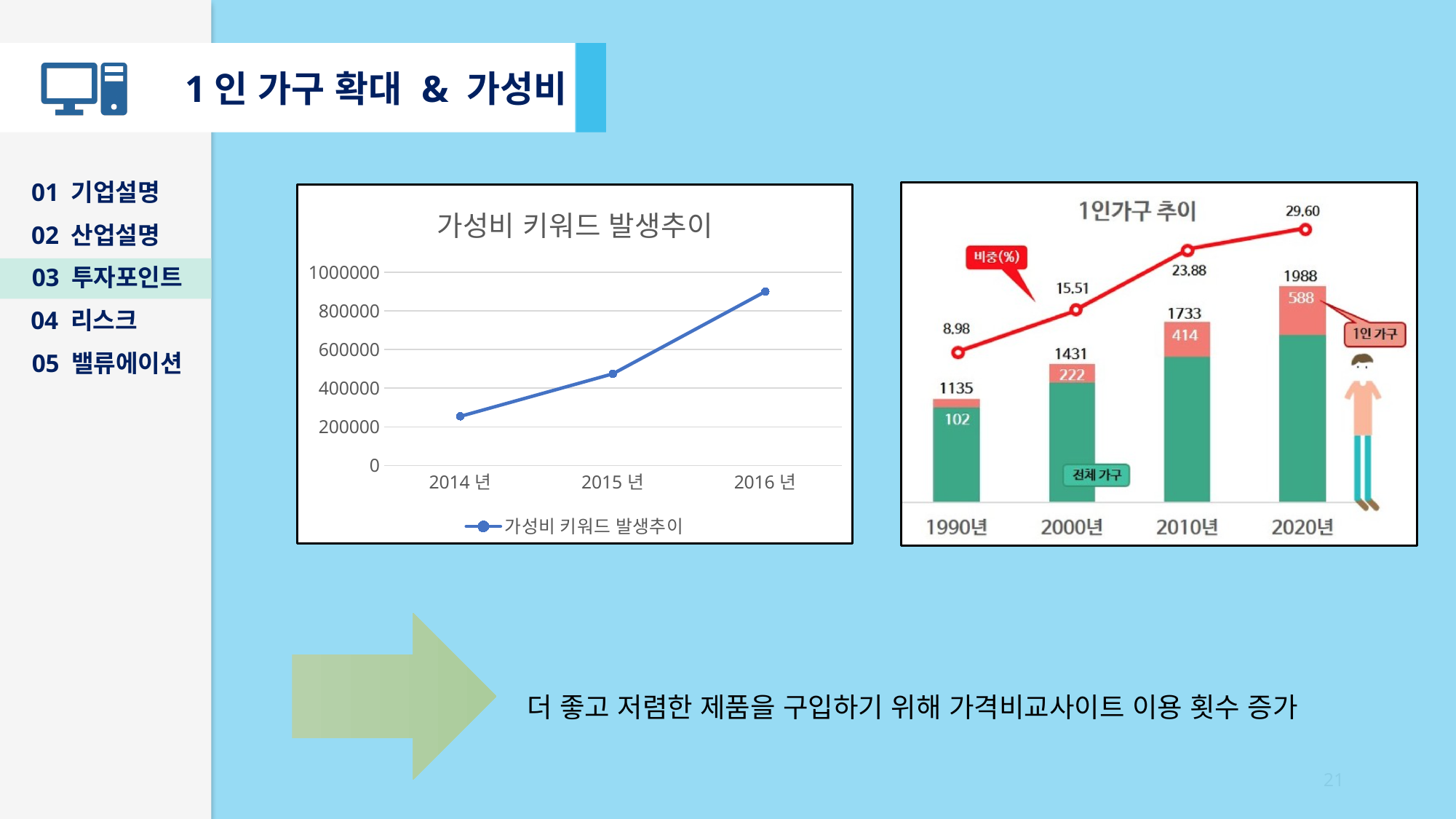
In the chart titled 1인가구 추이 on the right, what is the 1인 가구 value for 2020년? 588 In the chart titled 가성비 키워드 발생추이 on the left, do the values rise or fall from 2014 년 to 2016 년? rise In the chart titled 가성비 키워드 발생추이 on the left, is the value for 2014 년 greater or less than 400000? less In the chart titled 가성비 키워드 발생추이 on the left, what kind of chart is it? line chart In the chart titled 가성비 키워드 발생추이 on the left, is the value for 2016 년 greater or less than 800000? greater In the chart titled 1인가구 추이 on the right, which year has the lowest 1인 가구 value? 1990년 In the chart titled 1인가구 추이 on the right, what is the difference between the 1인 가구 values for 2010년 and 2000년? 192 In the chart titled 1인가구 추이 on the right, which year has the highest 비중(%) value? 2020년 In the chart titled 가성비 키워드 발생추이 on the left, how many years are plotted on the x axis? 3 In the chart titled 1인가구 추이 on the right, what is the total bar value for 2010년? 1733 In the chart titled 1인가구 추이 on the right, which is larger, the 비중(%) value for 2000년 or for 2010년? 2010년 In the chart titled 1인가구 추이 on the right, what is the 비중(%) value for 1990년? 8.98